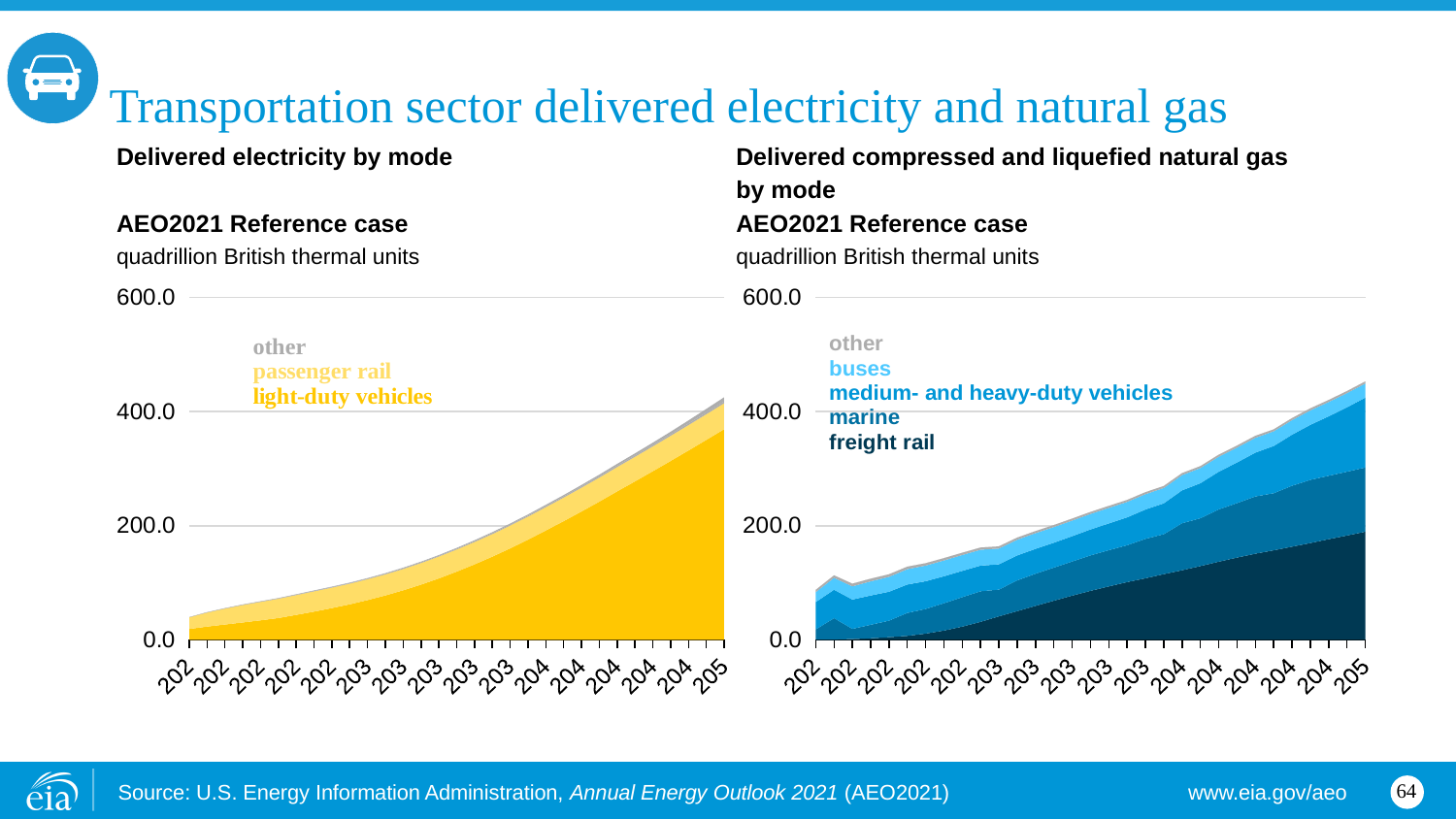
What kind of chart is the 'Delivered electricity by mode' chart? stacked area chart In the 'Delivered compressed and liquefied natural gas by mode' chart, do the total values rise or fall overall along the x axis? rise How many series does the legend of the 'Delivered compressed and liquefied natural gas by mode' chart list? 5 How many series does the legend of the 'Delivered electricity by mode' chart list? 3 In the 'Delivered electricity by mode' chart, do the total values rise or fall along the x axis? rise In the 'Delivered electricity by mode' chart, which series accounts for the largest share of the stacked area? light-duty vehicles In the 'Delivered electricity by mode' chart, is the total value at the left end of the x axis greater or less than 200.0? less In the 'Delivered electricity by mode' chart, is the total value at the right end of the x axis greater or less than 400.0? greater In the 'Delivered compressed and liquefied natural gas by mode' chart, is the total value at the left end of the x axis greater or less than 200.0? less What unit is given for the values in the 'Delivered electricity by mode' chart? quadrillion British thermal units What is the highest value shown on the y axis of the 'Delivered compressed and liquefied natural gas by mode' chart? 600.0